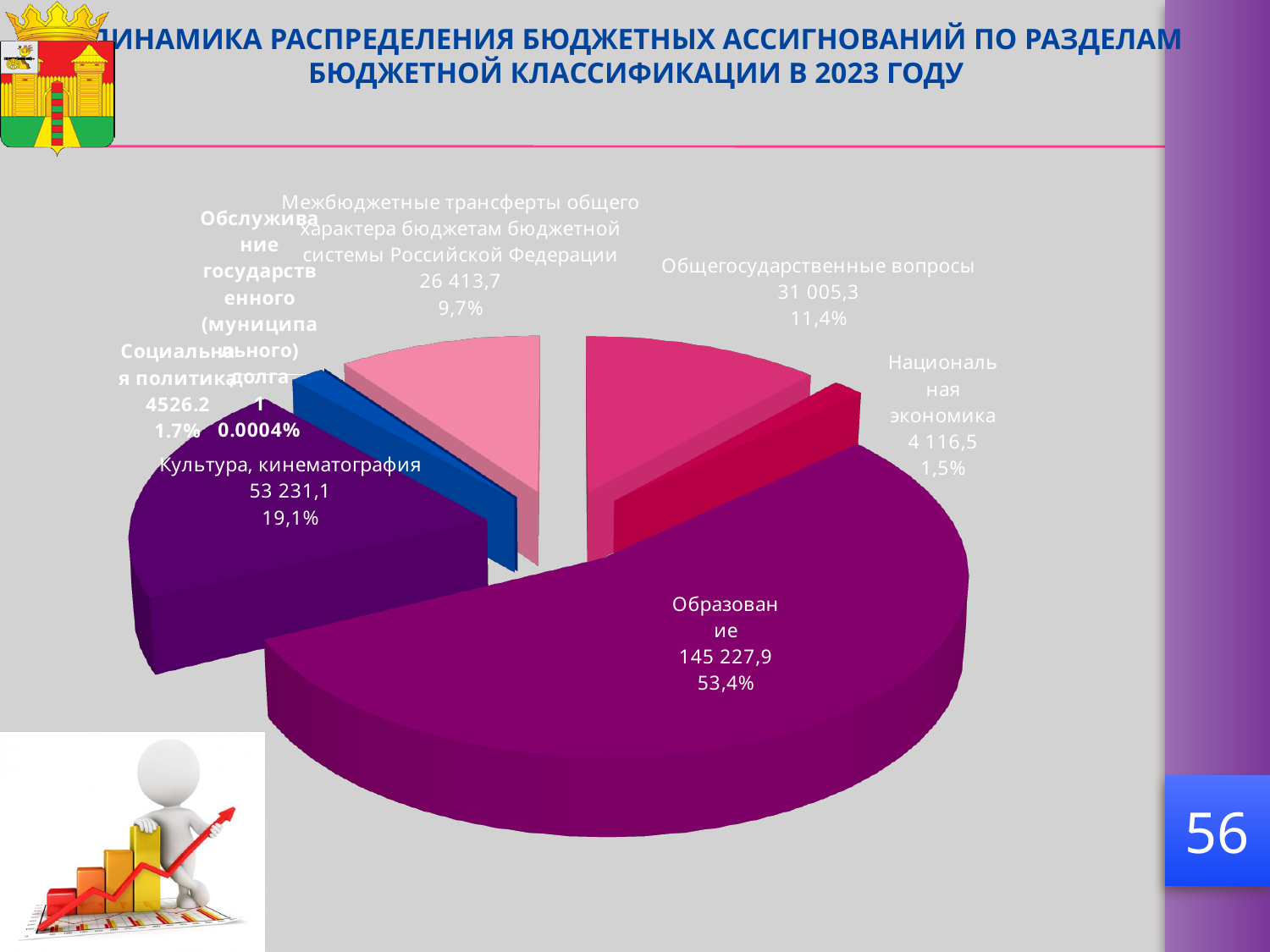
What is the value shown for Образование? 145 227,9 What is the value shown for Межбюджетные трансферты общего характера бюджетам бюджетной системы Российской Федерации? 26 413,7 Which category has the largest slice of the pie? Образование What is the value shown for Культура, кинематография? 53 231,1 What is the value shown for Общегосударственные вопросы? 31 005,3 What share of the pie does Образование account for? 53,4% What share of the pie does Национальная экономика account for? 1,5% What kind of chart is shown on the slide? Pie chart Which category has the smallest slice of the pie? Обслуживание государственного (муниципального) долга How many categories (slices) does the pie chart show? 7 What is the difference between the values for Образование and Культура, кинематография? 91 996,8 Which is larger: the value for Общегосударственные вопросы or the value for Межбюджетные трансферты общего характера бюджетам бюджетной системы Российской Федерации? Общегосударственные вопросы